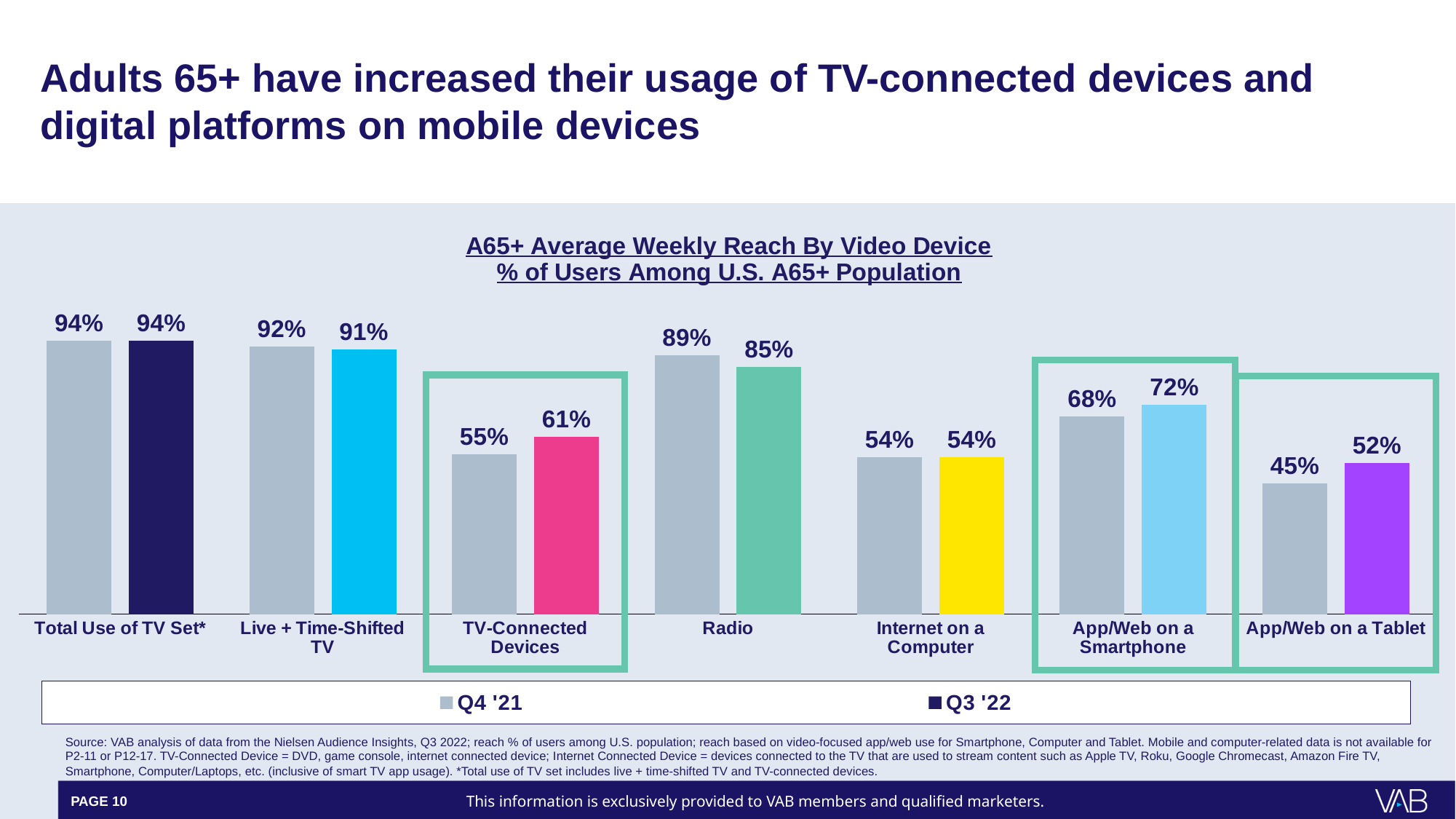
What are the two series named in the legend? Q4 '21 and Q3 '22 What is the Q4 '21 value for App/Web on a Tablet? 45% What kind of chart is shown on the slide? Bar chart Which category has the lowest Q4 '21 value? App/Web on a Tablet How many series does the legend list? 2 How many categories are shown on the x axis? 7 Which category has the highest Q3 '22 value? Total Use of TV Set* What is the difference between the Q3 '22 and Q4 '21 values for App/Web on a Tablet? 7% What is the Q3 '22 value for Radio? 85% What is the Q3 '22 value for TV-Connected Devices? 61% Which is larger, the Q3 '22 value for App/Web on a Smartphone or the Q3 '22 value for TV-Connected Devices? App/Web on a Smartphone What is the difference between the Q4 '21 and Q3 '22 values for Radio? 4%